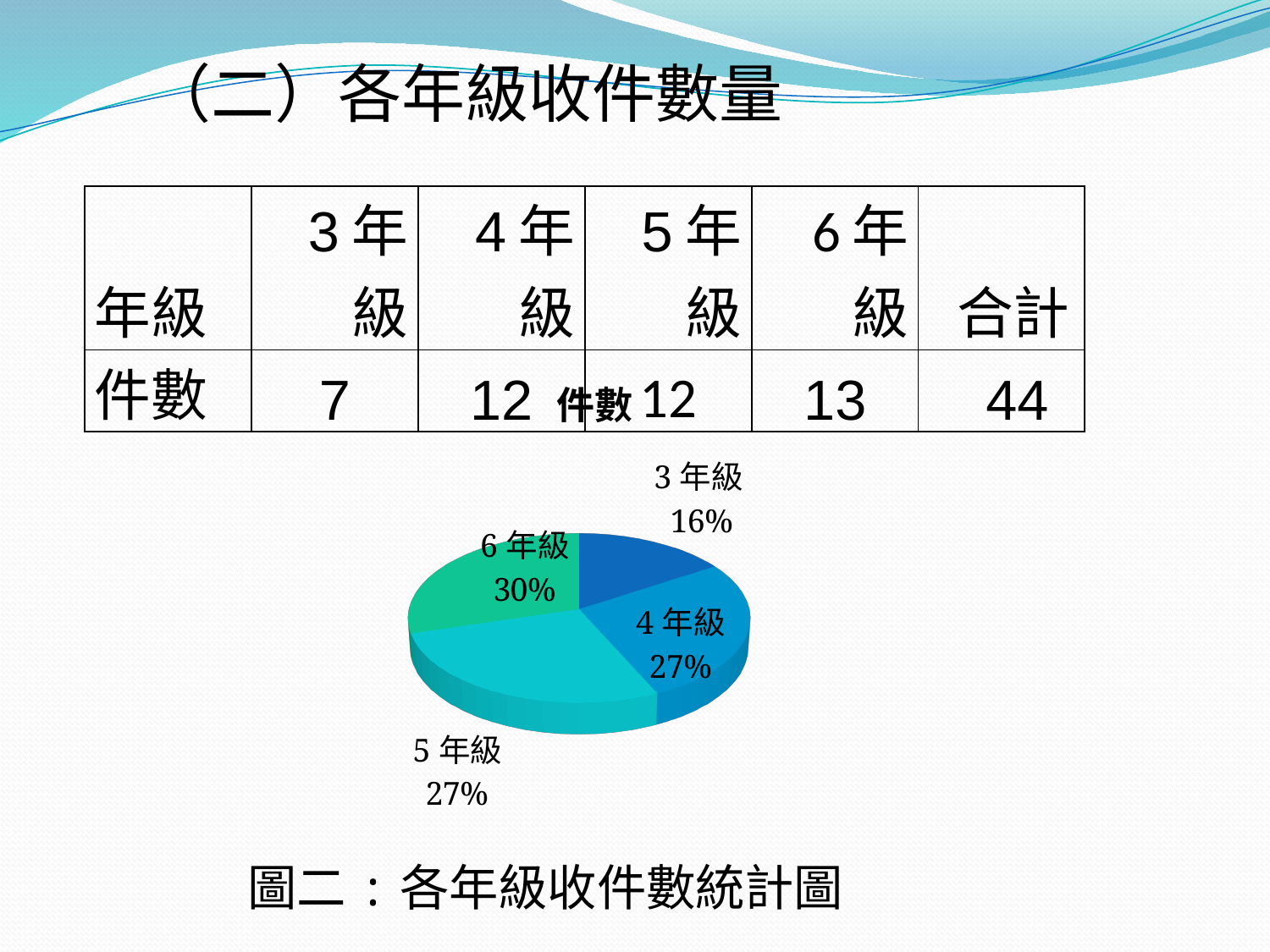
What kind of chart is shown on the slide? pie chart Which grade has the largest slice of the pie chart? 6 年級 Which slice is larger, 6 年級 or 3 年級? 6 年級 What percentage is shown for 5 年級 in the pie chart? 27% What is the title of the pie chart? 件數 What is the difference in percentage points between the 6 年級 slice and the 3 年級 slice? 14 Which grade has the smallest slice of the pie chart? 3 年級 What share of the pie does 3 年級 account for? 16% How many slices does the pie chart have? 4 What share of the pie does 6 年級 account for? 30% Which slice is larger, 4 年級 or 3 年級? 4 年級 What percentage is shown for 4 年級 in the pie chart? 27%